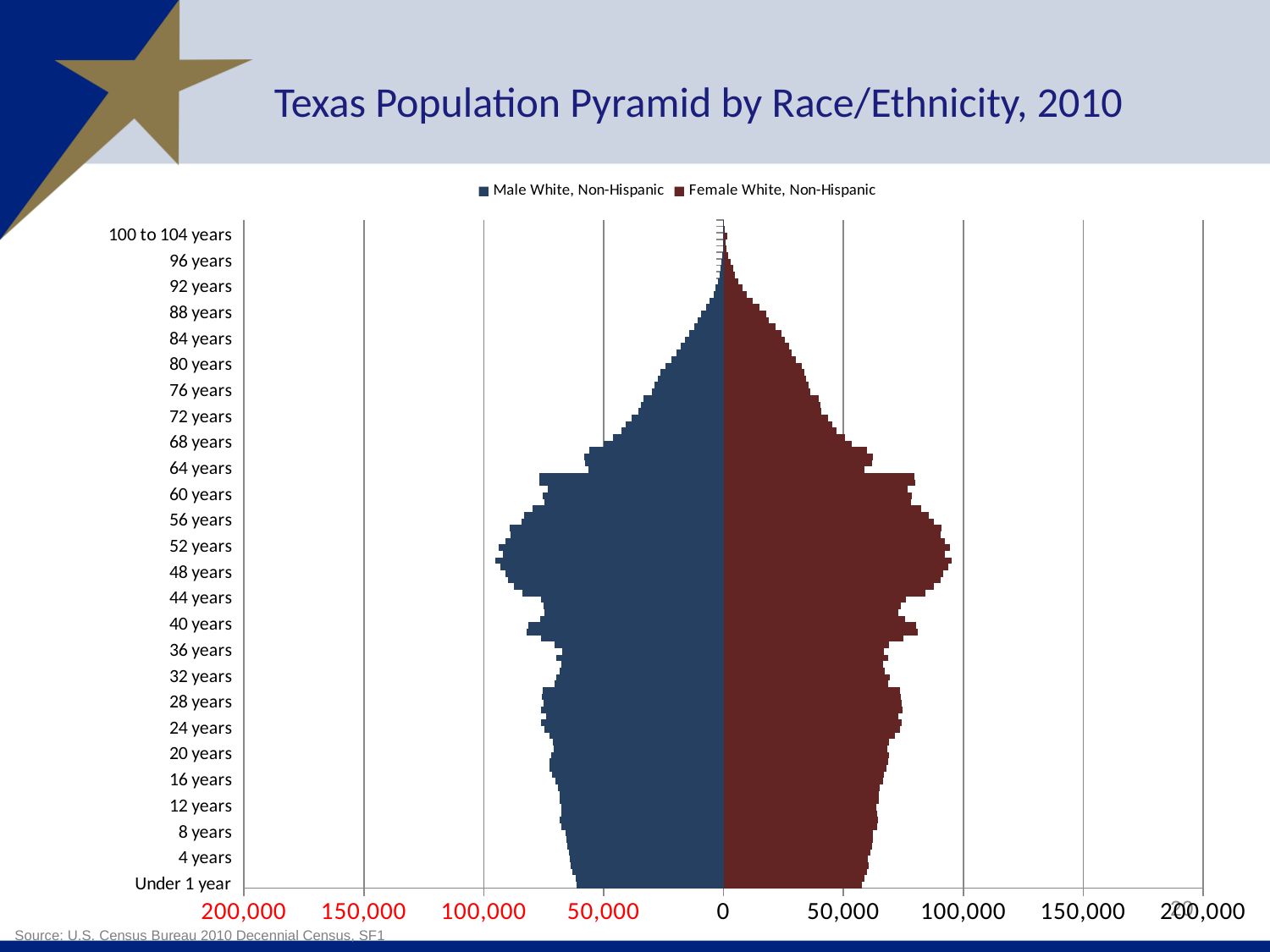
Is the value for Male White, Non-Hispanic at 4 years greater or less than 50,000? greater Do the values for Female White, Non-Hispanic rise or fall as age increases from 52 years to 100 to 104 years? fall What kind of chart is shown on the slide? Bar chart (population pyramid) Is the value for Female White, Non-Hispanic at 52 years greater or less than 50,000? greater How many series does the legend list? 2 Is the value for Female White, Non-Hispanic at 84 years greater or less than 50,000? less Which is larger for Male White, Non-Hispanic: the value at 60 years or the value at 80 years? 60 years What is the title of the chart? Texas Population Pyramid by Race/Ethnicity, 2010 Which is larger for Female White, Non-Hispanic: the value at 52 years or the value at 88 years? 52 years Which series is shown in dark red? Female White, Non-Hispanic